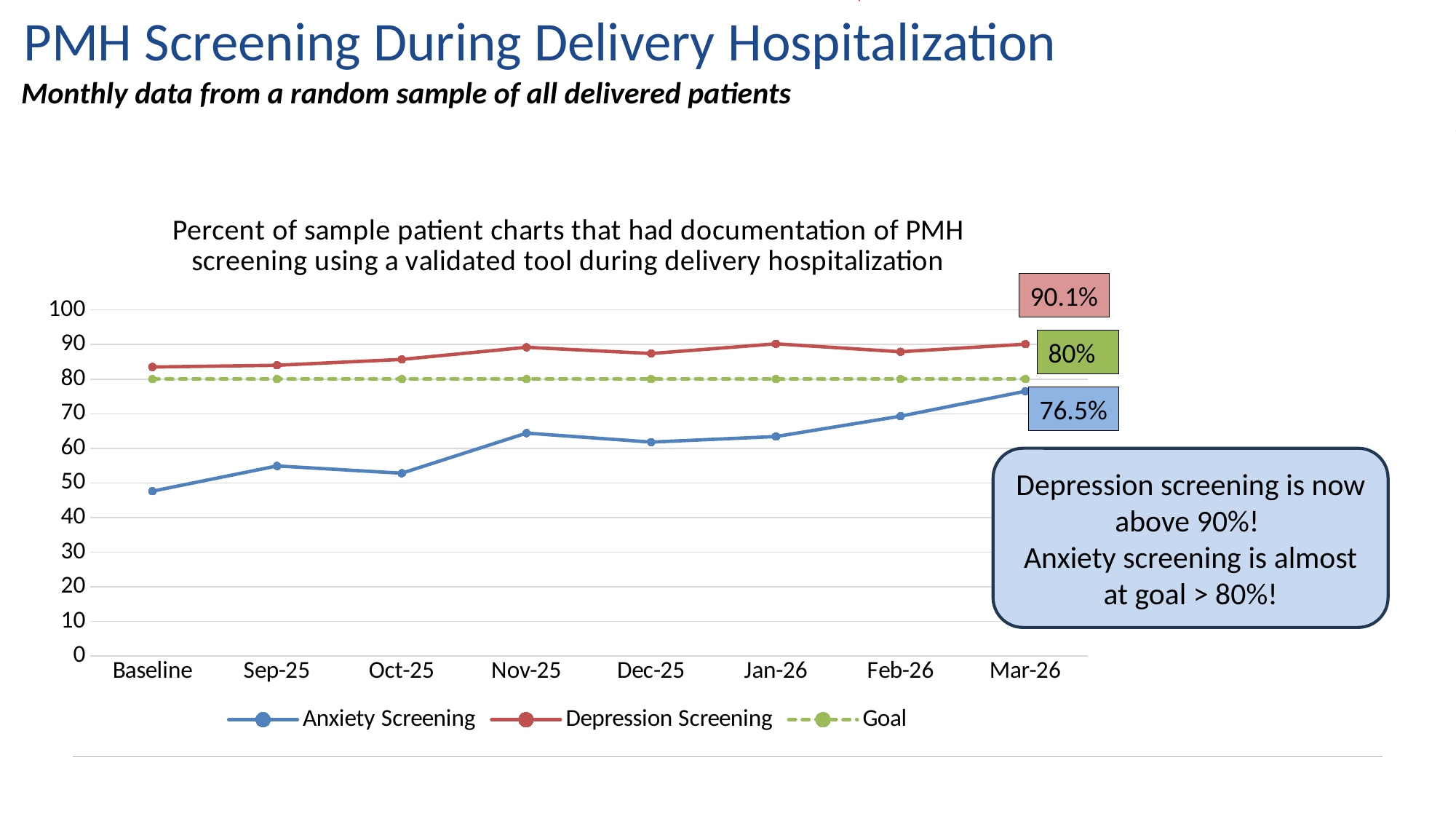
How many series does the chart legend list? 3 How far below the Goal is the Anxiety Screening value for Mar-26? 3.5 percentage points Does the Anxiety Screening line rise or fall overall from Baseline to Mar-26? rise Is the Anxiety Screening value for Baseline greater or less than 60? less At which point on the x axis is Anxiety Screening lowest? Baseline What is the difference between the Depression Screening and Anxiety Screening values for Mar-26? 13.6 percentage points Is the Depression Screening value for Baseline greater or less than 80? greater What kind of chart is shown on the slide? line chart What is the value of the Goal line? 80% What is the Anxiety Screening value for Mar-26? 76.5% What is the Depression Screening value for Mar-26? 90.1% How many points are plotted along the x axis of the chart? 8